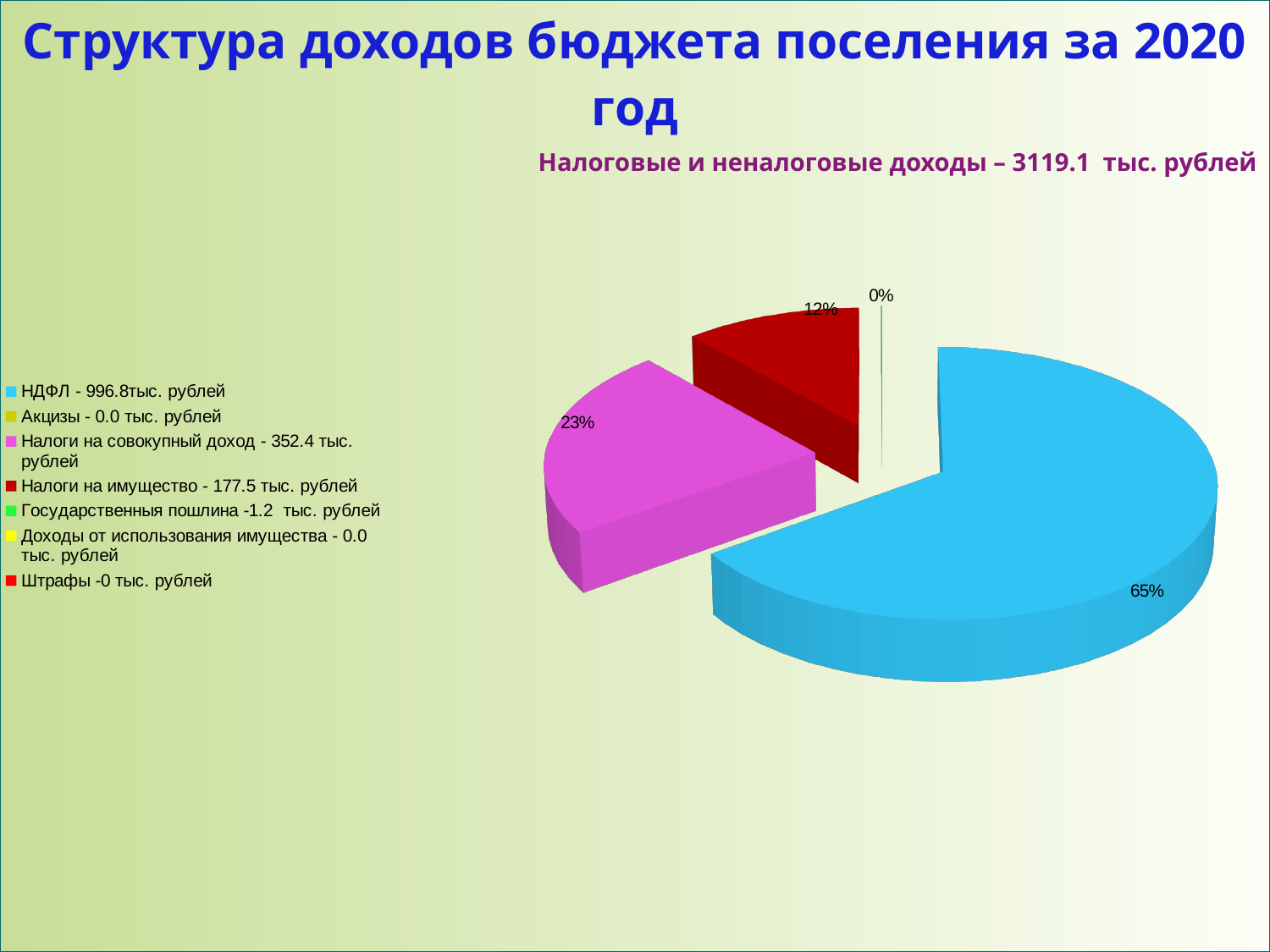
According to the legend, what is the value for Государственная пошлина? 1.2 тыс. рублей What share of the pie does НДФЛ take? 65% What share of the pie does Налоги на совокупный доход take? 23% How many entries does the legend list? 7 What is the difference between the legend values for НДФЛ and Налоги на совокупный доход, in тыс. рублей? 644.4 According to the legend, what is the value for Налоги на совокупный доход? 352.4 тыс. рублей What total amount of tax and non-tax revenue is stated above the chart? 3119.1 тыс. рублей Which is larger, the slice for Налоги на совокупный доход or the slice for Налоги на имущество? Налоги на совокупный доход Which category has the largest slice of the pie? НДФЛ What kind of chart is shown on the slide? pie chart What share of the pie does Налоги на имущество take? 12% According to the legend, what is the value for Налоги на имущество? 177.5 тыс. рублей